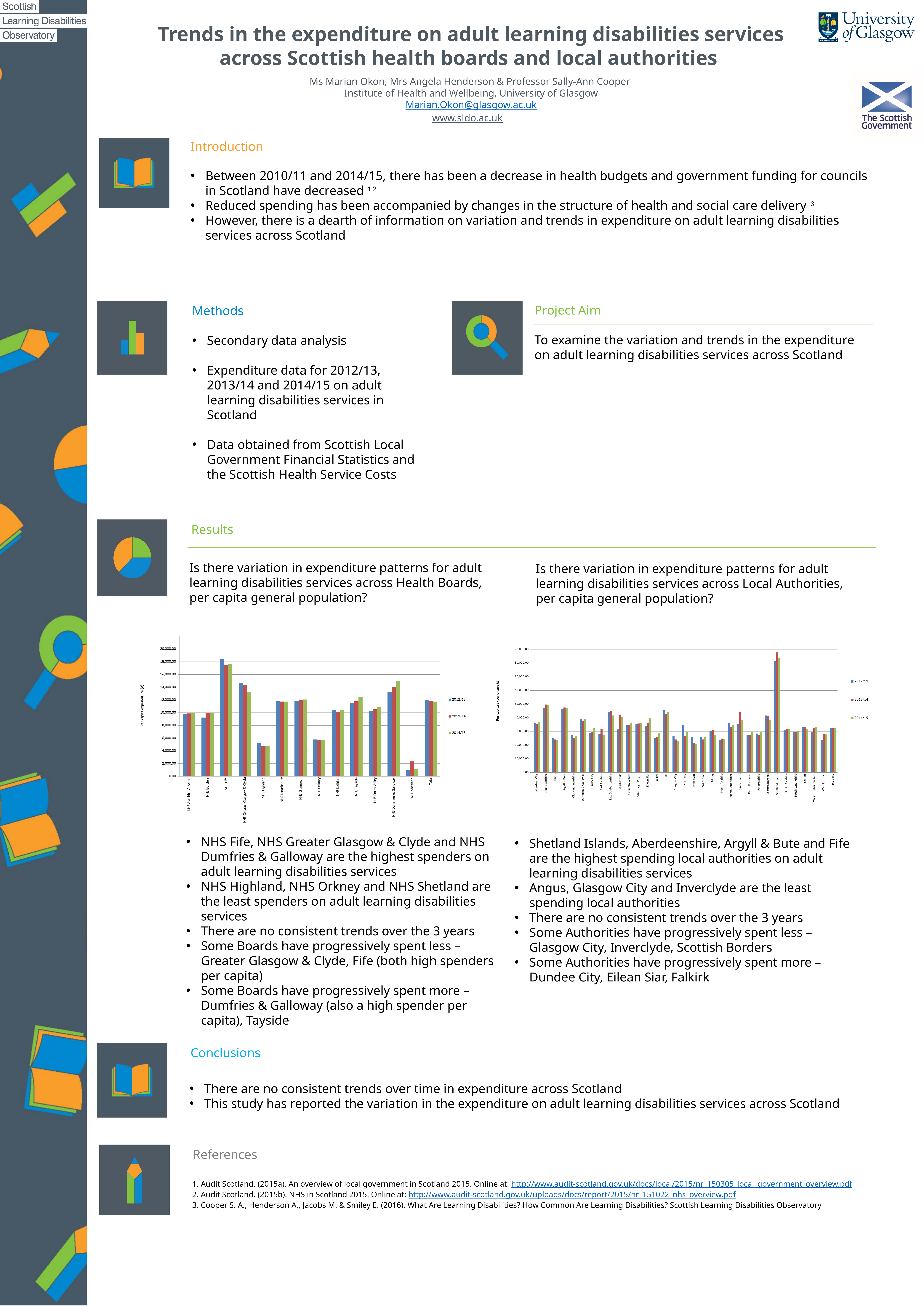
What are the legend entries of the right chart (Local Authorities)? 2012/13, 2013/14, 2014/15 How many series does the legend of the left chart (Health Boards) list? 3 In the left chart (Health Boards), do the values for NHS Dumfries & Galloway rise or fall from 2012/13 to 2014/15? rise In the left chart (Health Boards), which is larger for 2012/13: NHS Fife or NHS Borders? NHS Fife In the left chart (Health Boards), which category has the highest bar? NHS Fife In the left chart (Health Boards), is the 2012/13 value for NHS Fife greater or less than 16,000.00? greater In the right chart (Local Authorities), which local authority has the highest bars? Shetland Islands In the left chart (Health Boards), which health board has the lowest bars? NHS Shetland In the left chart (Health Boards), do the values for NHS Greater Glasgow & Clyde rise or fall from 2012/13 to 2014/15? fall In the right chart (Local Authorities), is the 2013/14 value for Shetland Islands greater or less than 70,000.00? greater In the left chart (Health Boards), is the 2012/13 value for NHS Highland greater or less than 8,000.00? less What kind of chart is the left chart about Health Boards? bar chart